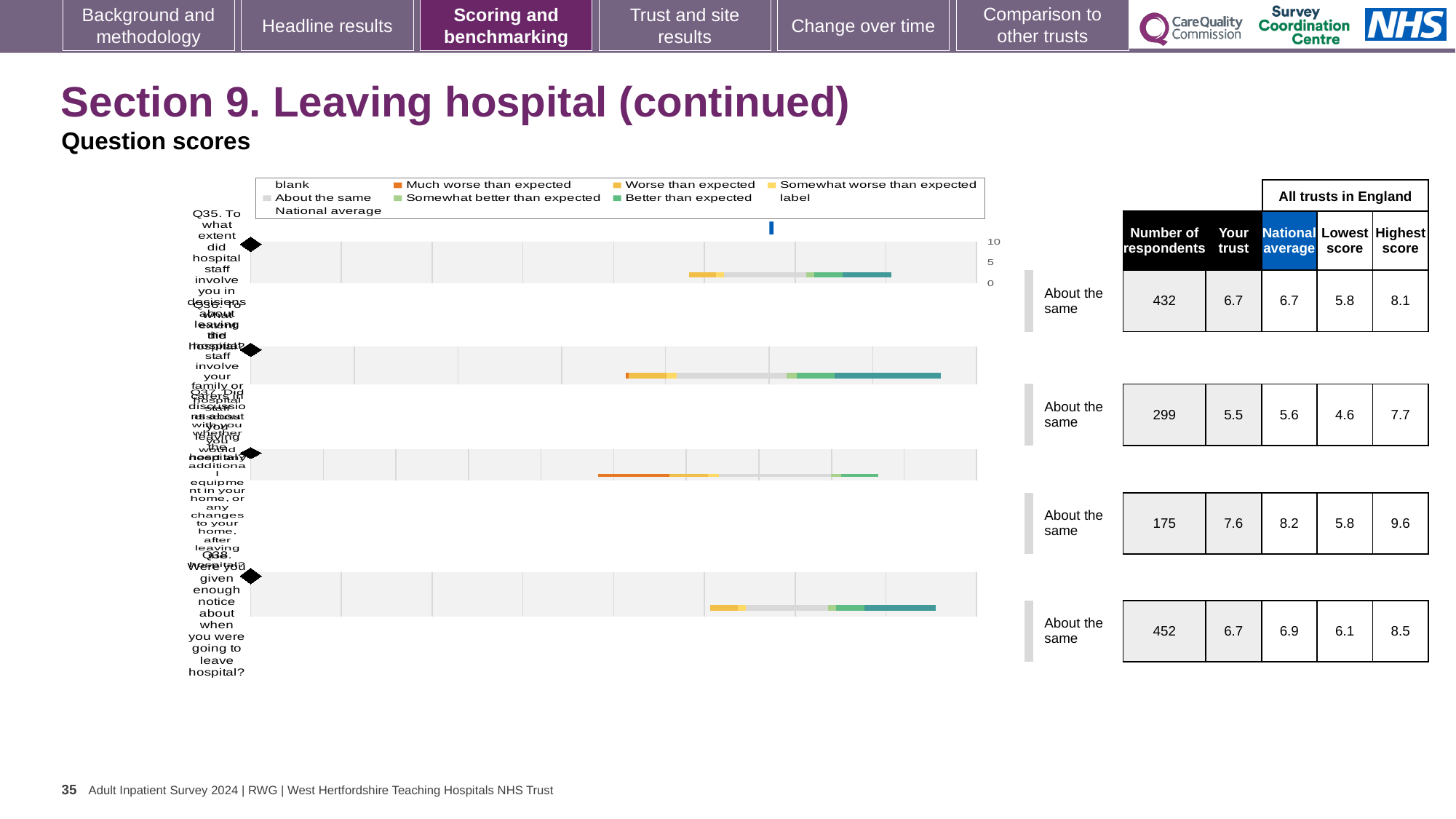
What is the national average score for Q35? 6.7 How many questions are plotted in the question scores chart? 4 For Q38, which is larger: the 'Your trust' score or the national average? National average What is the highest score among all trusts in England for Q38? 8.5 What benchmark category is shown for Q35? About the same What is the 'Your trust' score for Q35 (To what extent did hospital staff involve you in decisions about leaving the hospital?)? 6.7 What is the lowest 'Your trust' score shown in the table? 5.5 What is the difference between the highest score and the lowest score for Q35? 2.3 Which question has the highest number of respondents? Q38 What type of chart is used to show the question scores on this slide? bar chart What is the difference between the national average and the 'Your trust' score for Q38? 0.2 How many respondents are shown for Q38 (Were you given enough notice about when you were going to leave hospital?)? 452